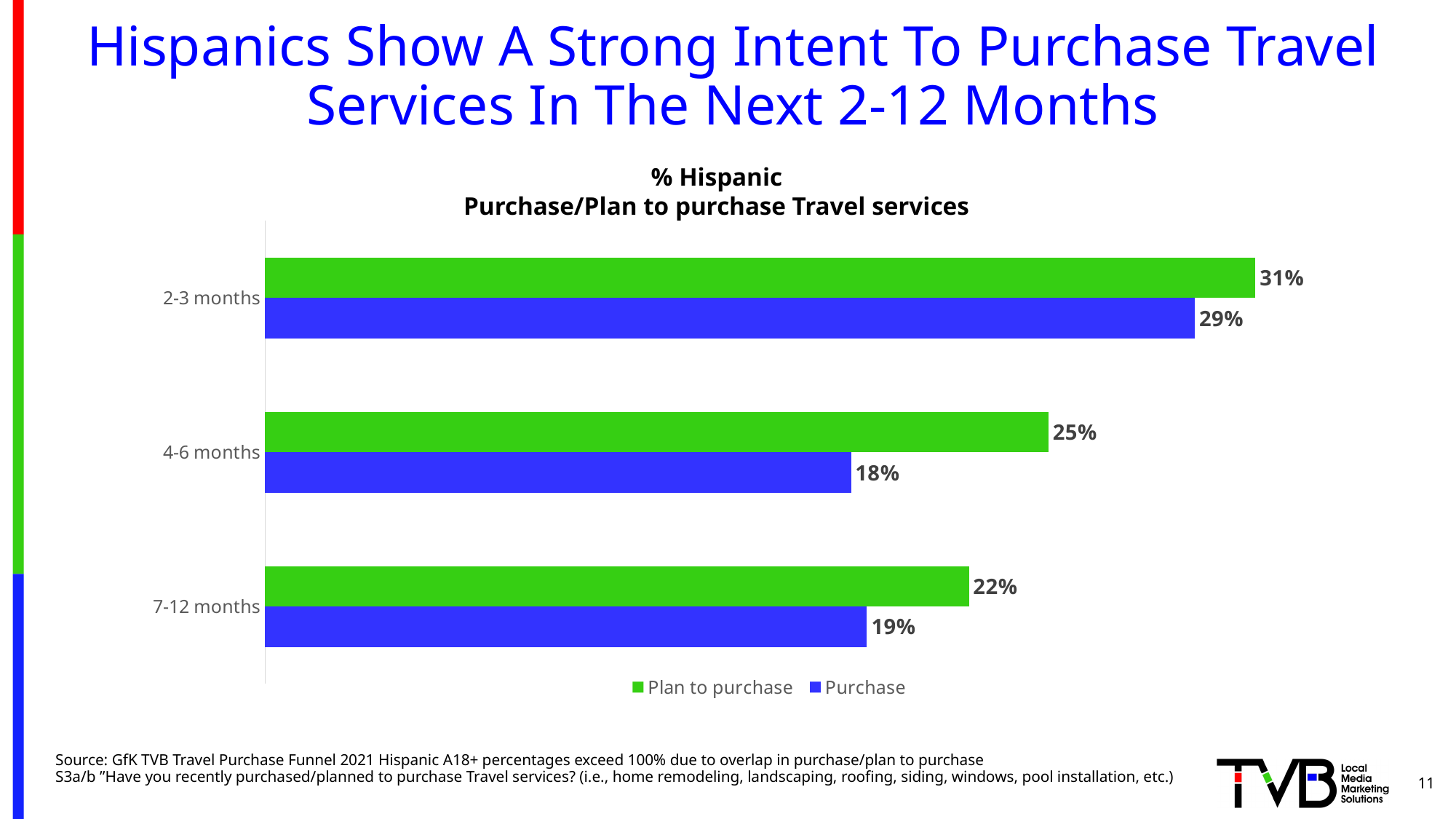
What colour represents the Purchase series in the chart? Blue Which time period has the lowest Purchase value? 4-6 months What is the Purchase value for 4-6 months? 18% What kind of chart is shown on the slide? Bar chart How many series does the legend list? 2 Which is larger for 7-12 months: Plan to purchase or Purchase? Plan to purchase What is the Purchase value for 7-12 months? 19% What is the Plan to purchase value for 2-3 months? 31% What is the difference between the Plan to purchase values for 2-3 months and 7-12 months? 9% How many time period categories are shown in the chart? 3 Which time period has the highest Plan to purchase value? 2-3 months What is the difference between the Plan to purchase and Purchase values for 4-6 months? 7%